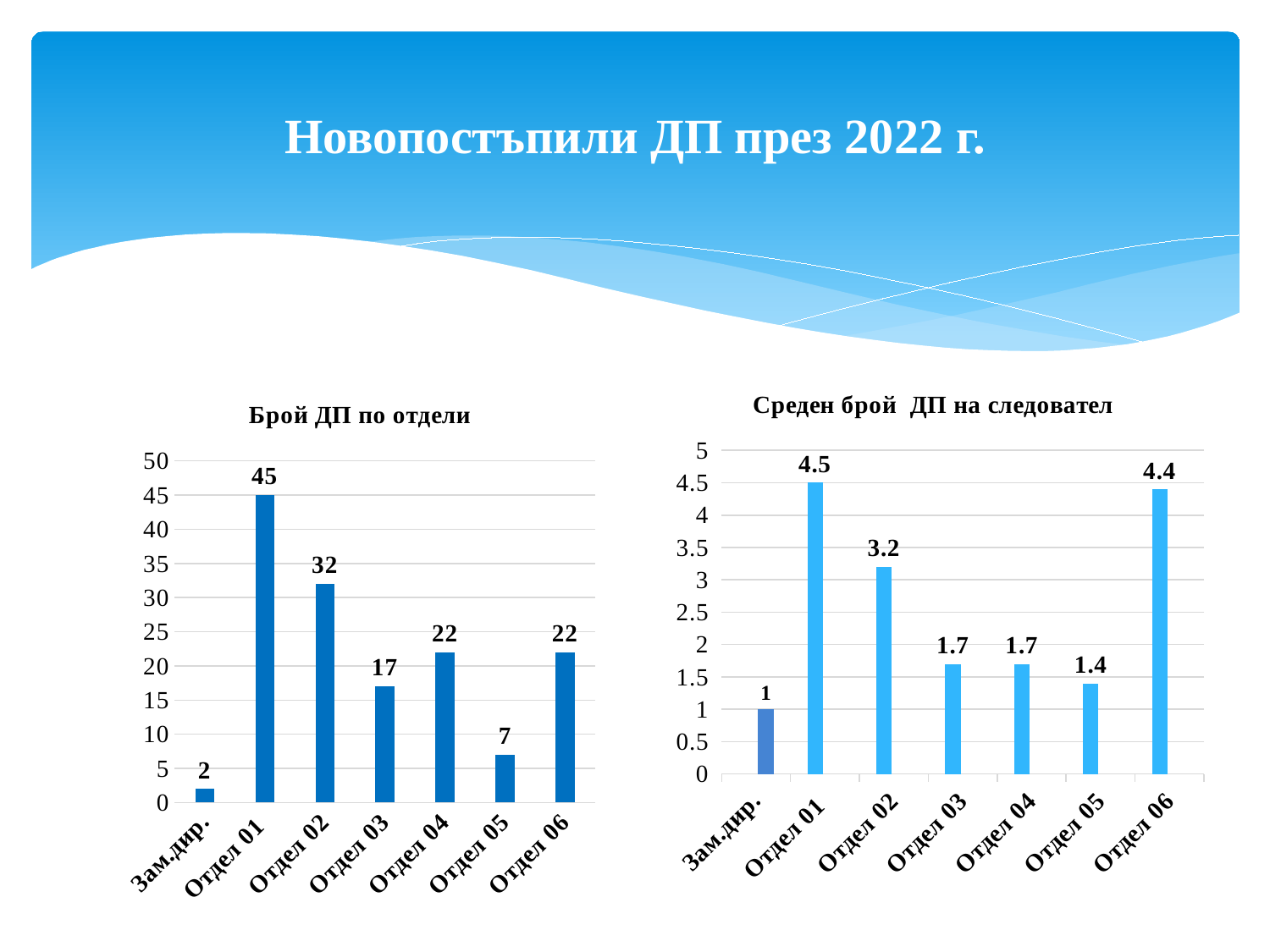
In the chart 'Брой ДП по отдели', how many categories are shown on the x axis? 7 In the chart 'Среден брой ДП на следовател', which is larger, the value for Отдел 02 or the value for Отдел 05? Отдел 02 In the chart 'Брой ДП по отдели', what is the difference between the values for Отдел 01 and Отдел 02? 13 In the chart 'Брой ДП по отдели', what is the value for Отдел 05? 7 In the chart 'Среден брой ДП на следовател', what is the difference between the values for Отдел 01 and Отдел 06? 0.1 In the chart 'Среден брой ДП на следовател', which category has the lowest value? Зам.дир. In the chart 'Среден брой ДП на следовател', what is the value for Отдел 06? 4.4 In the chart 'Брой ДП по отдели', what is the value for Отдел 02? 32 In the chart 'Брой ДП по отдели', which category has the lowest value? Зам.дир. In the chart 'Брой ДП по отдели', which category has the highest value? Отдел 01 In the chart 'Среден брой ДП на следовател', which category has the highest value? Отдел 01 What kind of chart is the chart on the right of the slide? Bar chart